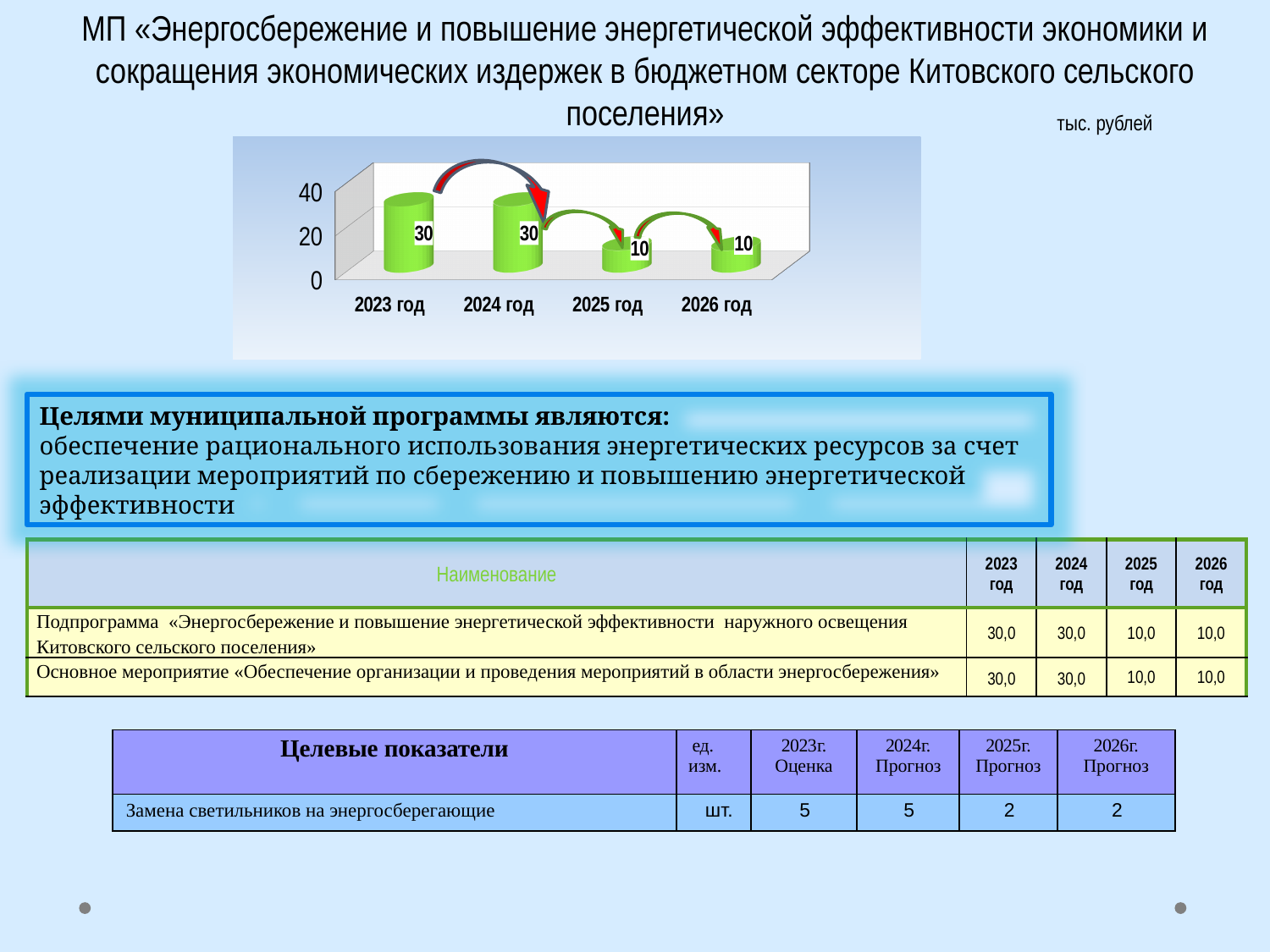
What unit is indicated for the chart values on the slide? тыс. рублей Is the value for 2025 год greater or less than 20? less Is the value for 2024 год greater or less than 20? greater What is the difference between the values for 2024 год and 2025 год on the chart? 20 What is the value shown for 2026 год on the chart? 10 What is the value shown for 2023 год on the chart? 30 Which year has the lowest value on the chart, 2024 год or 2026 год? 2026 год What is the value shown for 2025 год on the chart? 10 What is the highest value shown on the vertical axis of the chart? 40 What kind of chart is shown on the slide? bar chart How many years (categories) are plotted on the chart? 4 Do the values on the chart rise or fall from 2023 год to 2026 год? fall